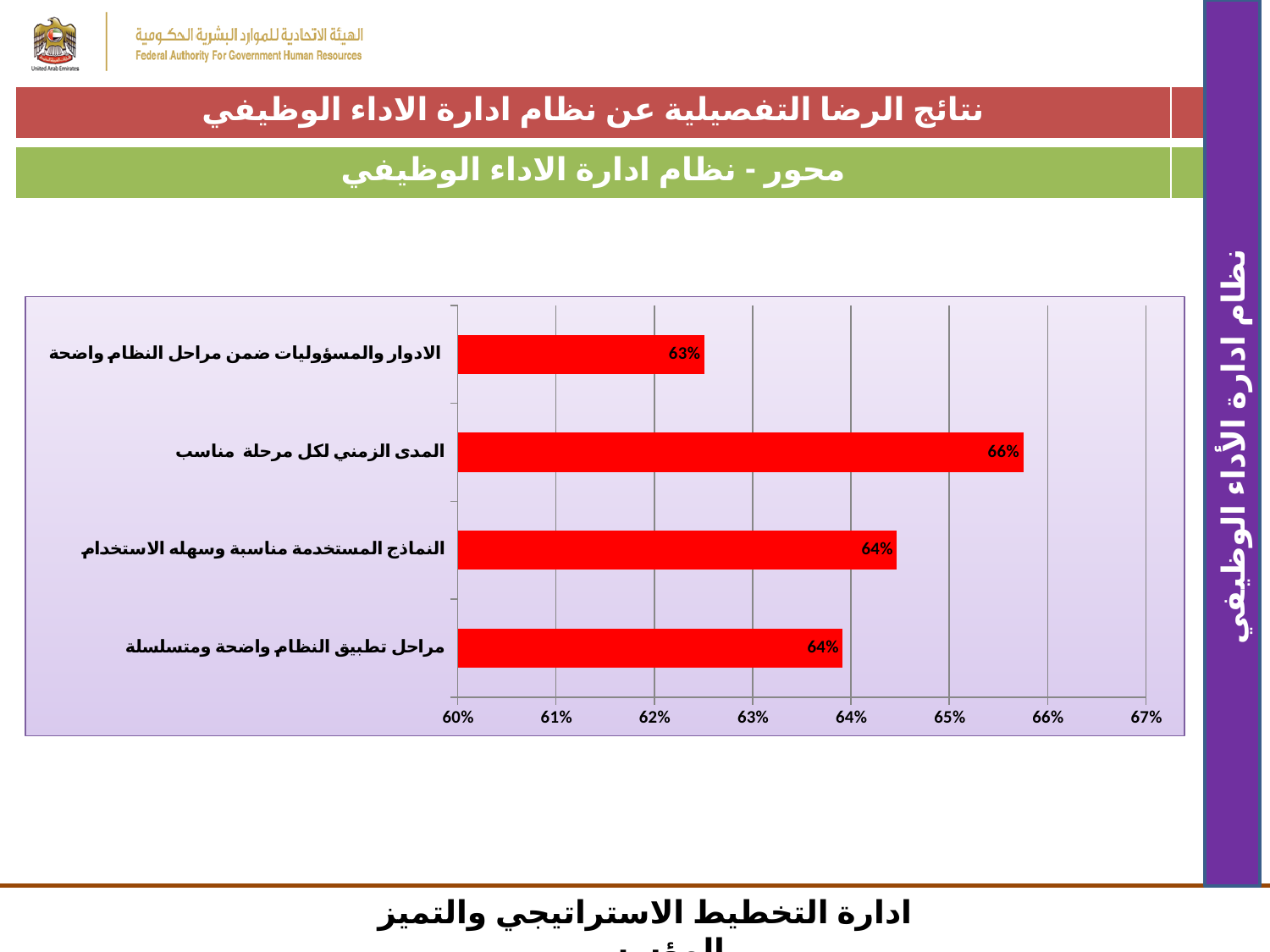
What is the value for النماذج المستخدمة مناسبة وسهله الاستخدام? 64% What is the difference between the values for المدى الزمني لكل مرحلة مناسب and الادوار والمسؤوليات ضمن مراحل النظام واضحة? 3% What kind of chart is shown on the slide? bar chart What is the value for المدى الزمني لكل مرحلة مناسب? 66% How many categories are shown in the chart? 4 What is the value for مراحل تطبيق النظام واضحة ومتسلسلة? 64% What colour are the bars in the chart? red Is the value for المدى الزمني لكل مرحلة مناسب greater or less than 65%? greater What is the value for الادوار والمسؤوليات ضمن مراحل النظام واضحة? 63% Which category has the highest value? المدى الزمني لكل مرحلة مناسب Which category has the lowest value? الادوار والمسؤوليات ضمن مراحل النظام واضحة Which is larger, the value for المدى الزمني لكل مرحلة مناسب or the value for النماذج المستخدمة مناسبة وسهله الاستخدام? المدى الزمني لكل مرحلة مناسب